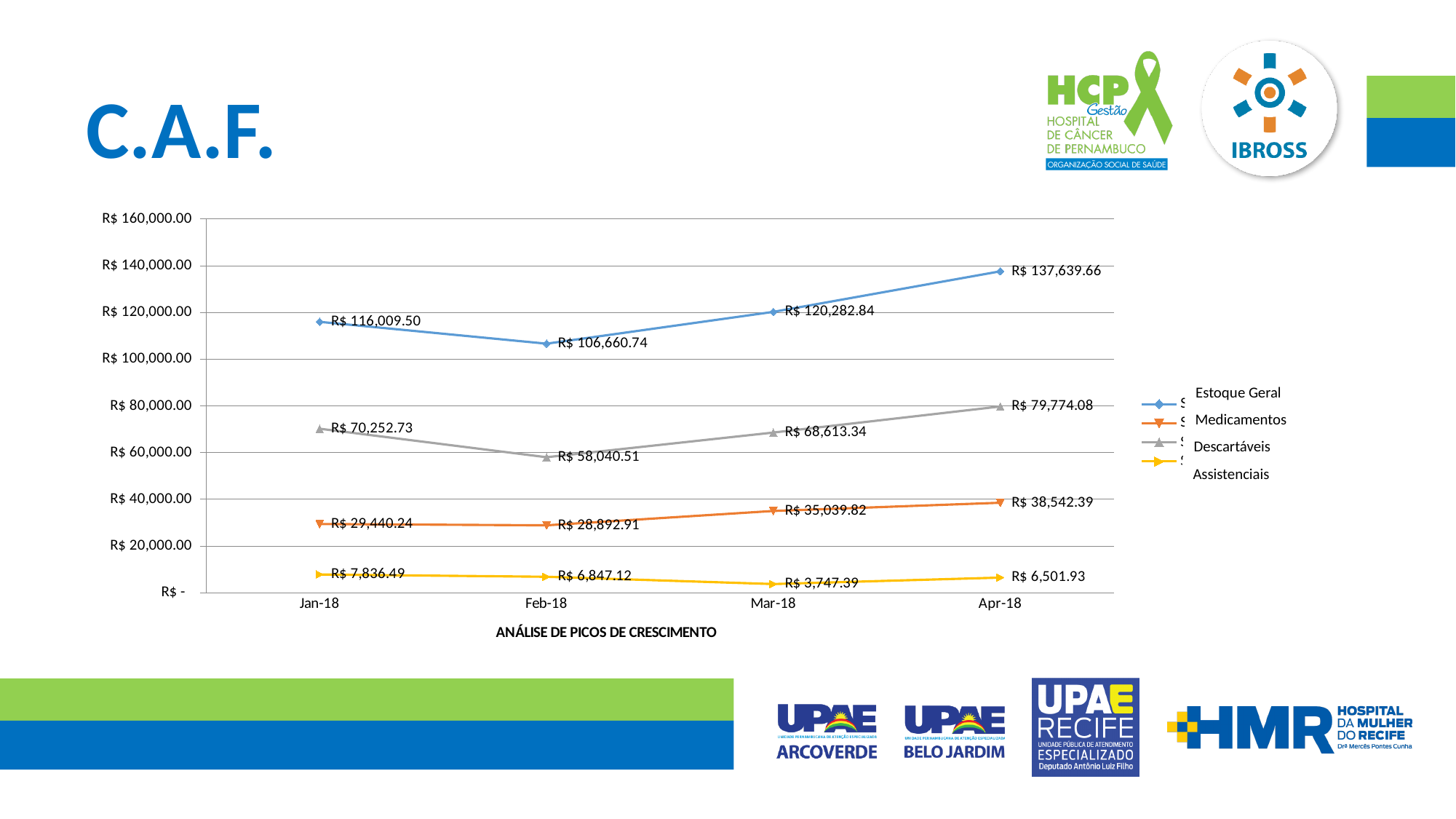
In which month is Assistenciais lowest? Mar-18 What is the value of Assistenciais in Jan-18? R$ 7,836.49 By how much did Estoque Geral increase from Jan-18 to Apr-18? R$ 21,630.16 Which is larger: Descartáveis in Jan-18 or Descartáveis in Mar-18? Descartáveis in Jan-18 What type of chart is shown on the slide? Line chart In which month is Estoque Geral lowest? Feb-18 What is the value of Medicamentos in Mar-18? R$ 35,039.82 What is the value of Descartáveis in Feb-18? R$ 58,040.51 How many months are plotted along the x axis? 4 What is the value of Estoque Geral in Apr-18? R$ 137,639.66 How many series does the legend list? 4 What is the title shown below the chart? ANÁLISE DE PICOS DE CRESCIMENTO